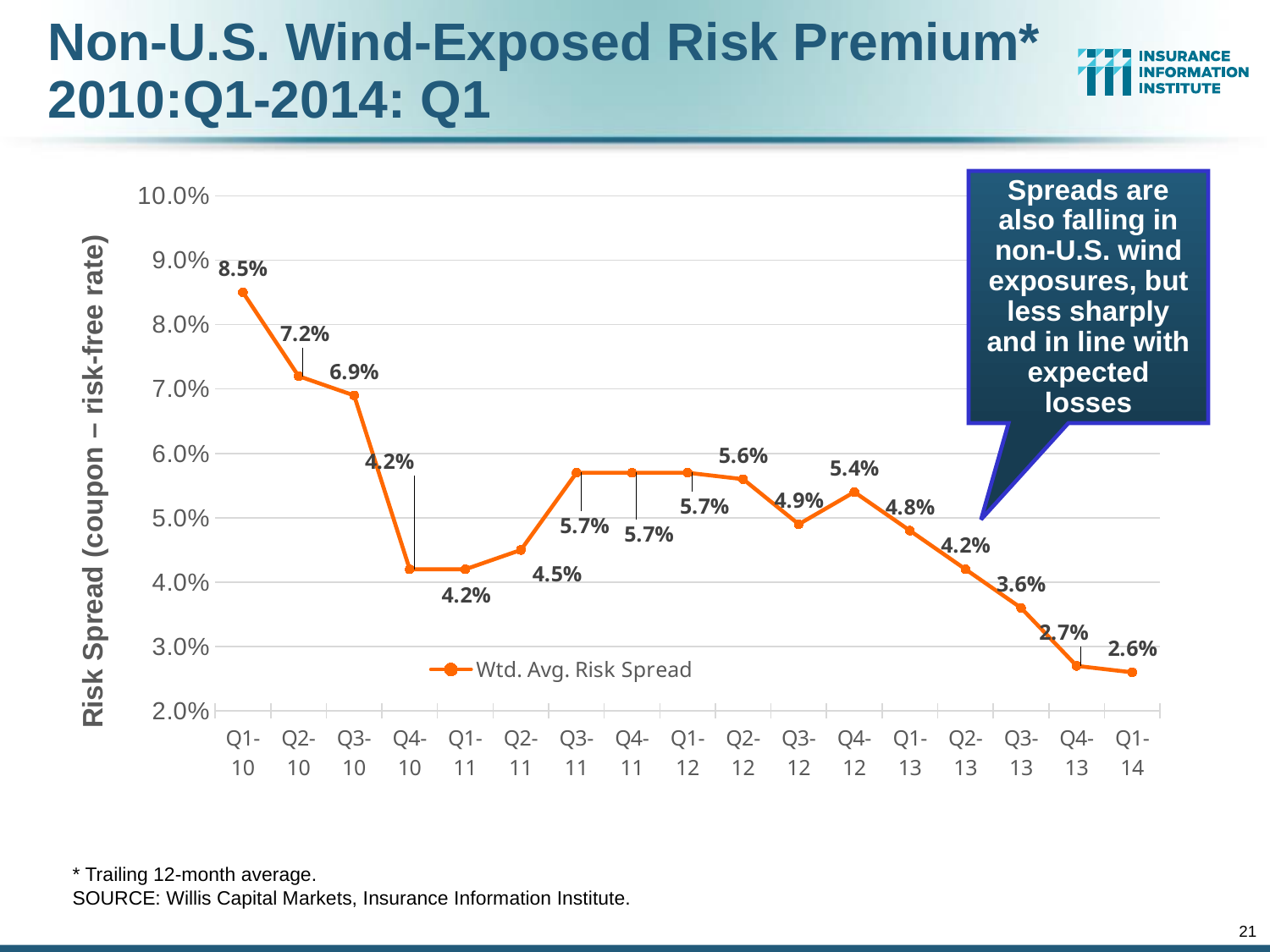
What is the difference between the risk spread in Q1-10 and Q1-14? 5.9% What is the weighted average risk spread for Q1-10? 8.5% What kind of chart is shown on the slide? line chart Which quarter has the lowest weighted average risk spread? Q1-14 Which quarter has the highest weighted average risk spread? Q1-10 Which is larger, the risk spread in Q2-10 or in Q3-10? Q2-10 Is the value for Q3-13 greater or less than 4.0%? less What is the name of the series shown in the legend? Wtd. Avg. Risk Spread How many quarters are plotted on the chart? 17 What is the weighted average risk spread for Q1-14? 2.6% What is the weighted average risk spread for Q4-12? 5.4% How many series does the legend list? 1